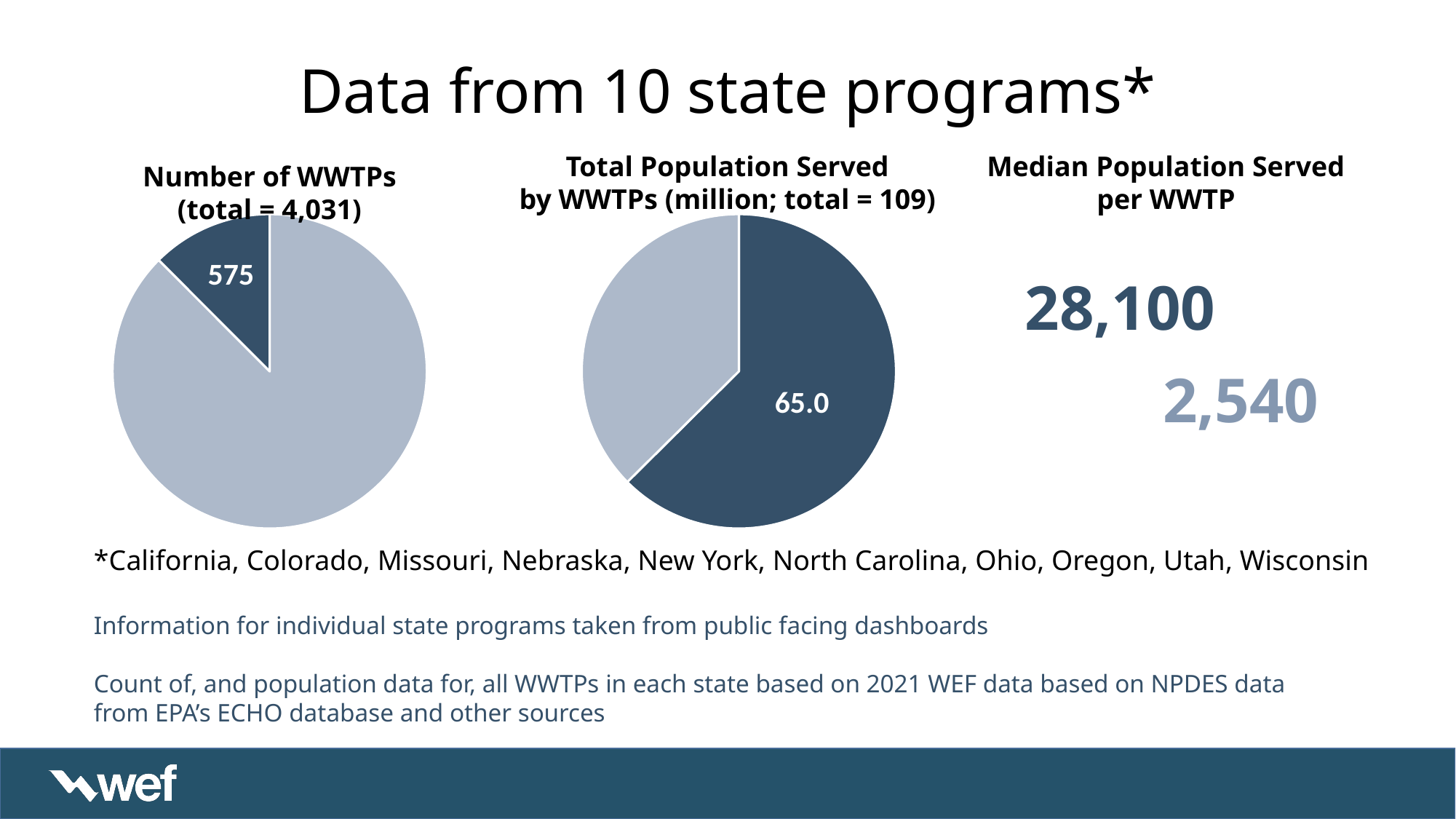
In the 'Total Population Served by WWTPs' pie chart, which slice is larger, the dark blue slice or the light grey slice? the dark blue slice In the 'Total Population Served by WWTPs' pie chart, what value is printed on the dark blue slice? 65.0 What kind of chart is the 'Number of WWTPs' chart? pie chart What total is given in the title of the 'Number of WWTPs' pie chart? 4,031 In the 'Number of WWTPs' pie chart, which slice is larger, the dark blue slice or the light grey slice? the light grey slice How many slices does the 'Total Population Served by WWTPs' pie chart have? 2 How many slices does the 'Number of WWTPs' pie chart have? 2 In the 'Total Population Served by WWTPs' pie chart, given the total of 109 and the dark blue slice of 65.0, what is the value of the light grey slice? 44.0 What kind of chart is the 'Total Population Served by WWTPs' chart? pie chart In the 'Number of WWTPs' pie chart, what value is printed on the dark blue slice? 575 In the 'Number of WWTPs' pie chart, given the total of 4,031 and the dark blue slice of 575, what is the value of the light grey slice? 3,456 What total is given in the title of the 'Total Population Served by WWTPs' pie chart? 109